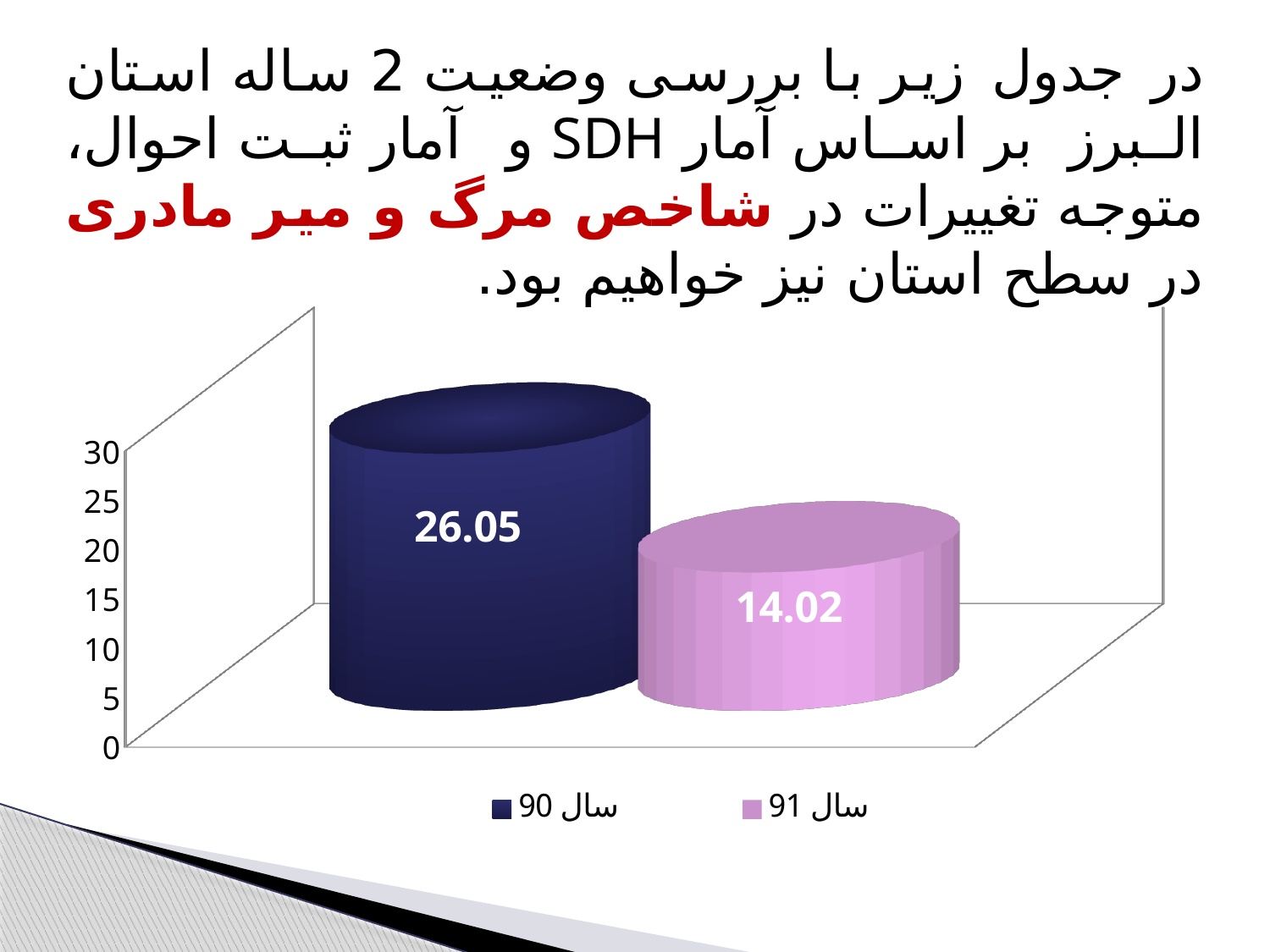
What is the value shown for سال 91? 14.02 Is the value for سال 91 greater or less than 15? less Which series has the higher value, سال 90 or سال 91? سال 90 Is the value for سال 90 greater or less than 25? greater Which series has the lower value? سال 91 Is the value for سال 90 larger than the value for سال 91? Yes What is the value shown for سال 90? 26.05 What colour is the bar for سال 91? Pink How many bars are plotted on the chart? 2 How many series does the legend list? 2 What kind of chart is shown on the slide? Bar chart What is the difference between the values for سال 90 and سال 91? 12.03